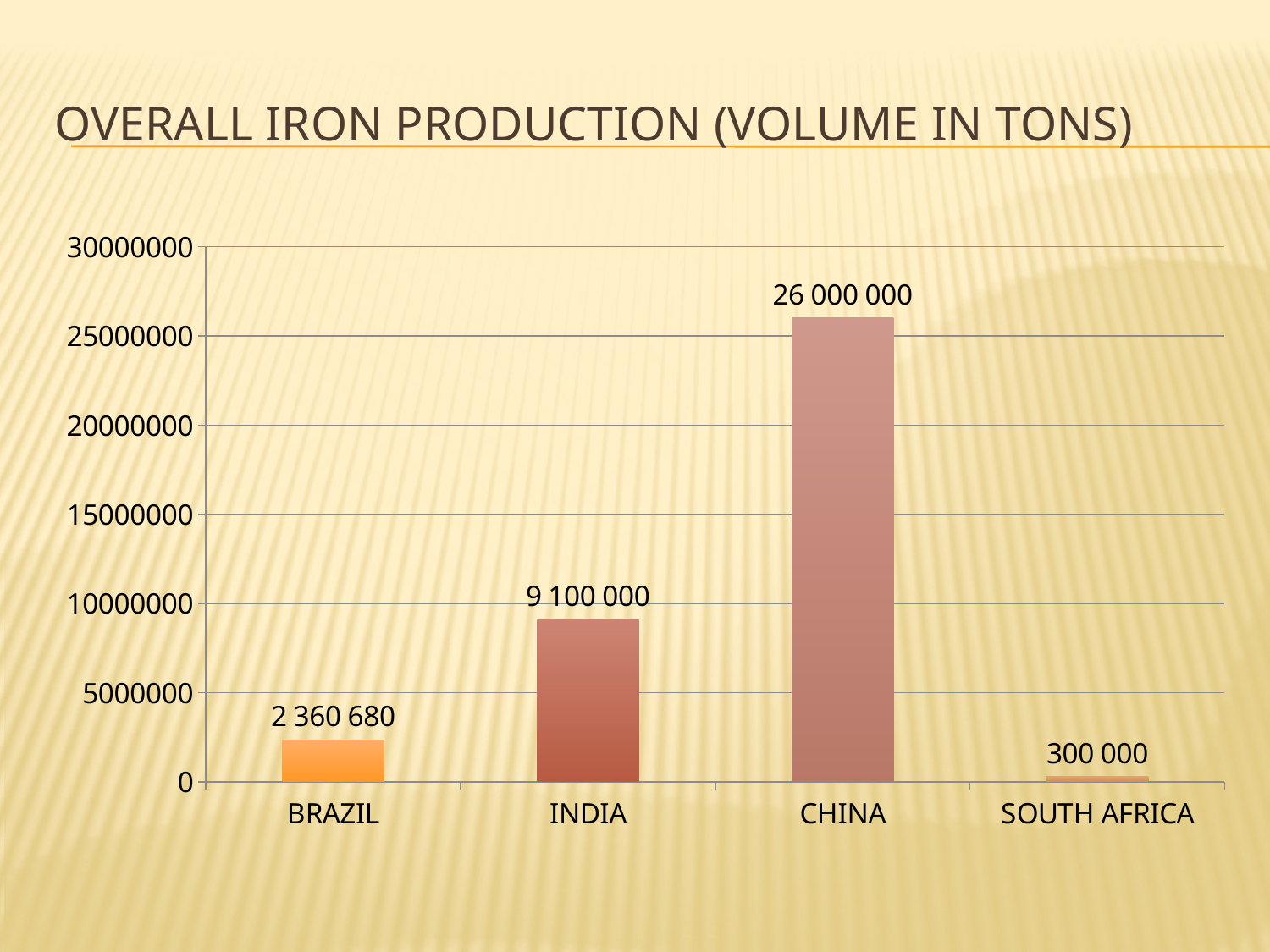
Which country has the lowest iron production? South Africa What is the difference in iron production between Brazil and South Africa? 2 060 680 What is the difference in iron production between China and India? 16 900 000 What is the iron production volume for South Africa? 300 000 What is the iron production volume for Brazil? 2 360 680 What type of chart is shown on the slide? Bar chart Which has a larger iron production, India or Brazil? India How many countries are shown in the chart? 4 What is the iron production volume for China? 26 000 000 Which country has the highest iron production? China What is the iron production volume for India? 9 100 000 Is the value for India greater or less than 10000000? less